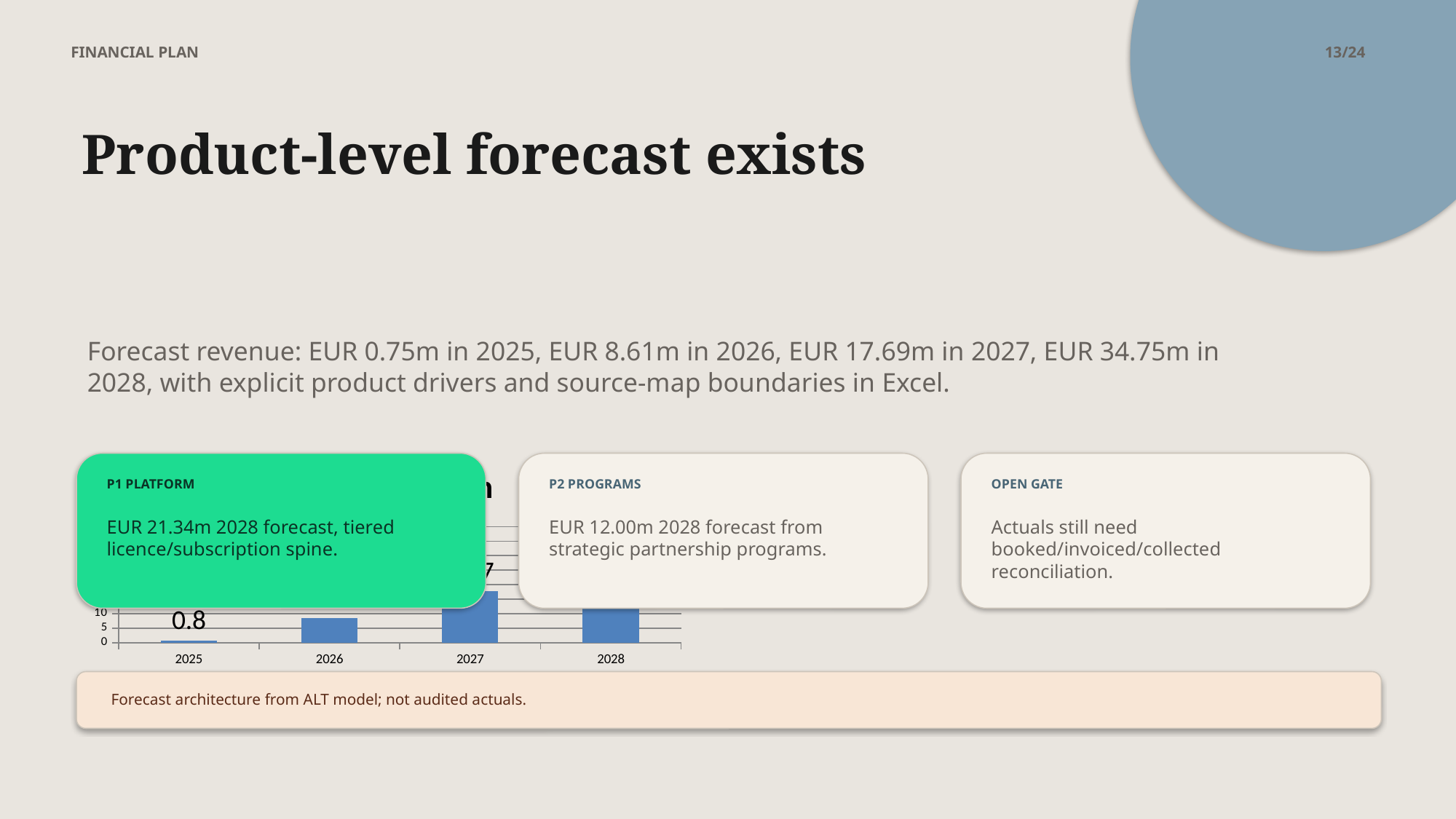
Which is larger, the bar for 2026 or the bar for 2027? 2027 Is the value for 2025 greater or less than 5? less How many years are shown on the x axis of the bar chart? 4 What is the first year shown on the x axis of the chart? 2025 Is the value for 2026 greater or less than 5? greater What kind of chart is shown at the bottom left of the slide? bar chart What colour are the bars in the chart? blue What is the data label shown on the bar for 2025? 0.8 Which is larger, the bar for 2025 or the bar for 2026? 2026 Is the value for 2027 greater or less than 10? greater Which year has the lowest bar in the chart? 2025